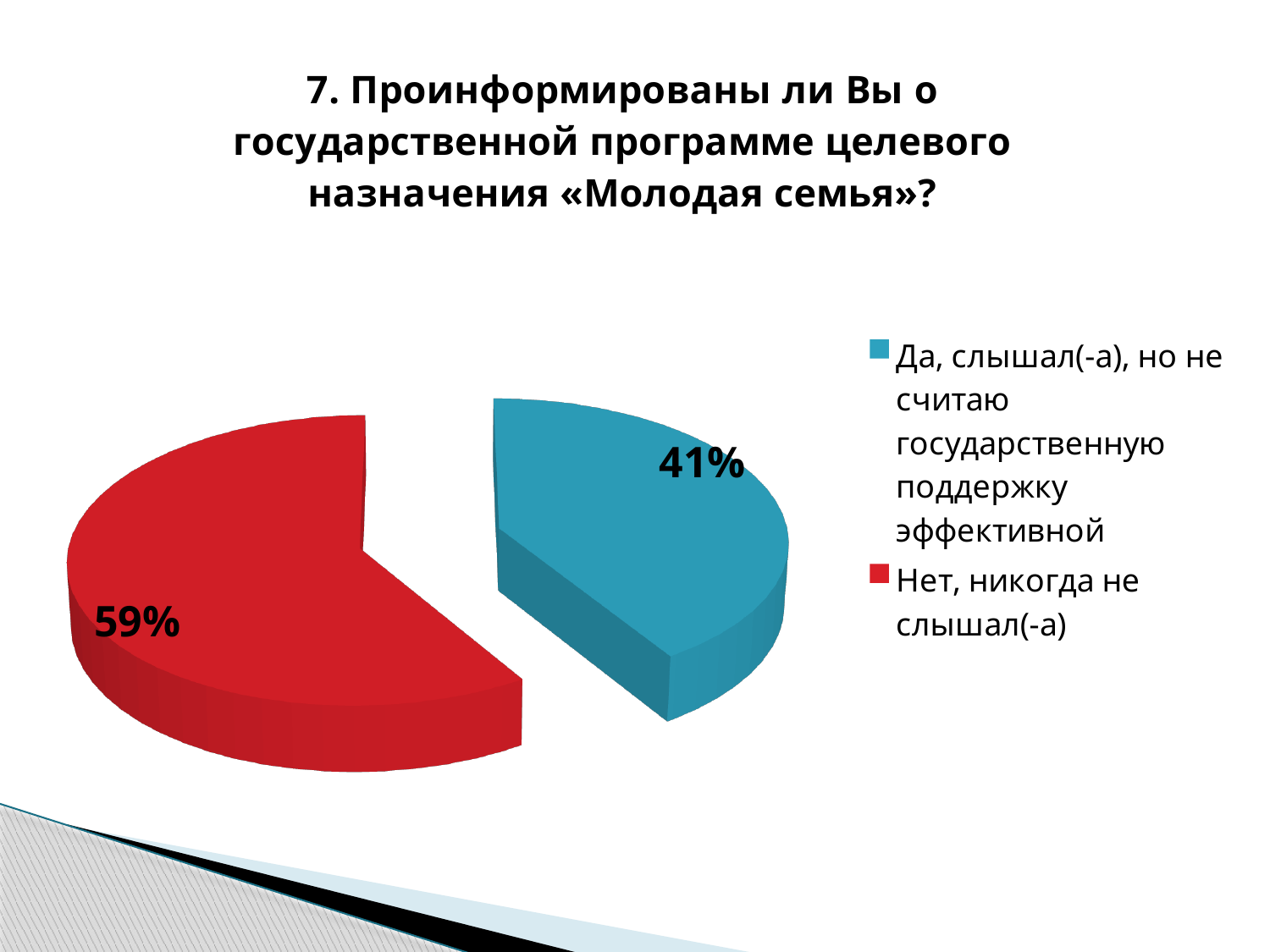
What share of the pie is labelled "Да, слышал(-а), но не считаю государственную поддержку эффективной"? 41% What kind of chart is shown on the slide? Pie chart How many entries does the legend list? 2 What colour is the slice for "Да, слышал(-а), но не считаю государственную поддержку эффективной"? Blue Which category has the largest slice of the pie? Нет, никогда не слышал(-а) Which category has the smallest slice of the pie? Да, слышал(-а), но не считаю государственную поддержку эффективной How many slices does the pie chart have? 2 What is the difference in percentage points between the "Нет, никогда не слышал(-а)" slice and the "Да, слышал(-а), но не считаю государственную поддержку эффективной" slice? 18% Which is larger: the share for "Да, слышал(-а), но не считаю государственную поддержку эффективной" or the share for "Нет, никогда не слышал(-а)"? Нет, никогда не слышал(-а) What colour is the slice for "Нет, никогда не слышал(-а)"? Red What share of the pie is labelled "Нет, никогда не слышал(-а)"? 59%